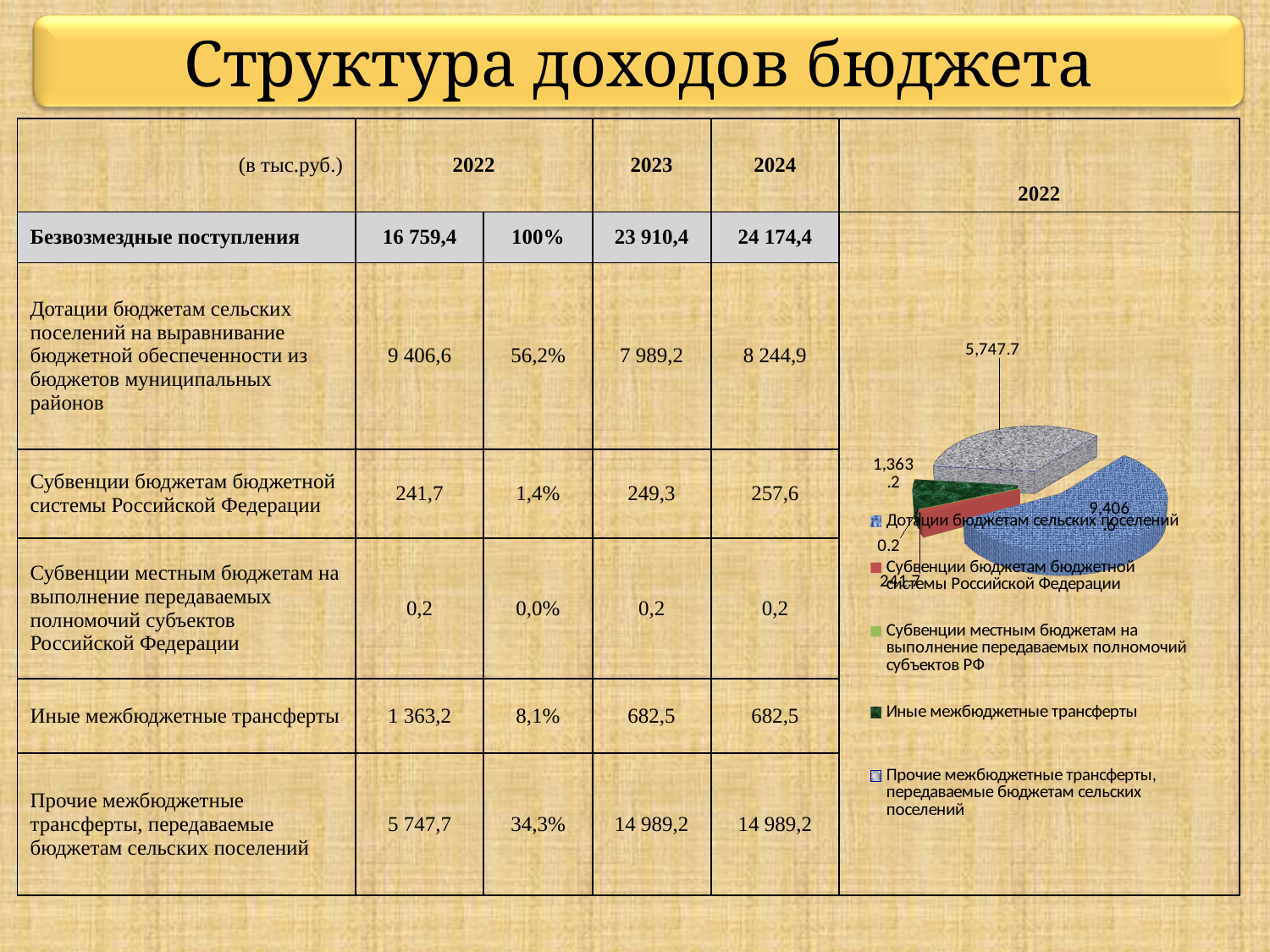
How many entries does the chart's legend list? 5 Which category has the smallest value in the pie chart? Субвенции местным бюджетам на выполнение передаваемых полномочий субъектов РФ What is the title of the chart on the slide? 2022 What is the difference between the values for "Прочие межбюджетные трансферты, передаваемые бюджетам сельских поселений" and "Иные межбюджетные трансферты" in the chart? 4,384.5 What value does the chart show for "Иные межбюджетные трансферты"? 1,363.2 Which is larger in the chart: "Прочие межбюджетные трансферты, передаваемые бюджетам сельских поселений" or "Иные межбюджетные трансферты"? Прочие межбюджетные трансферты, передаваемые бюджетам сельских поселений Which category has the largest slice in the pie chart? Дотации бюджетам сельских поселений What value does the chart show for "Субвенции бюджетам бюджетной системы Российской Федерации"? 241.7 What kind of chart is shown on the slide? pie chart What value does the chart show for "Прочие межбюджетные трансферты, передаваемые бюджетам сельских поселений"? 5,747.7 What value does the chart show for "Субвенции местным бюджетам на выполнение передаваемых полномочий субъектов РФ"? 0.2 How many slices does the pie chart have? 5